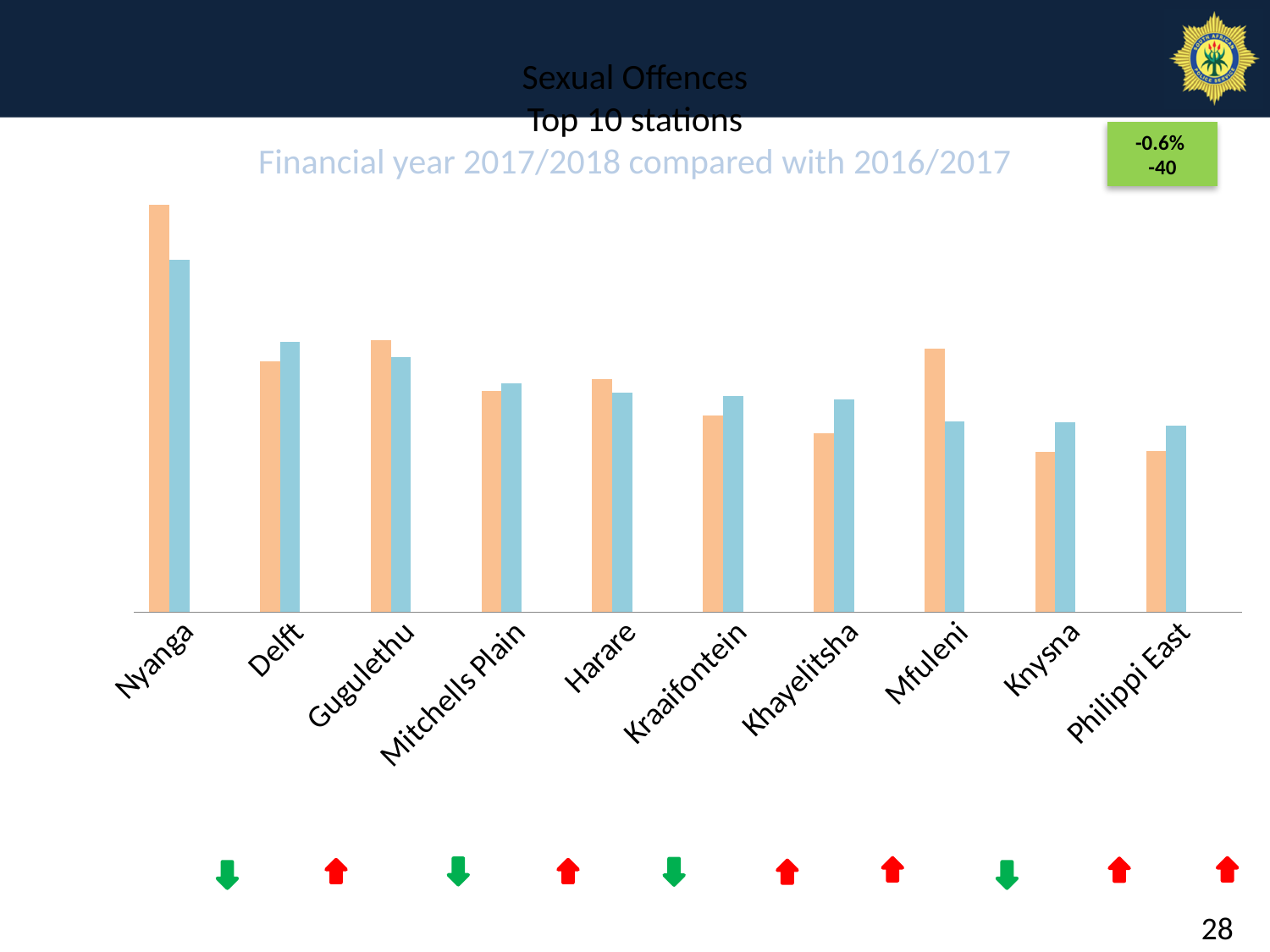
How many stations are shown on the x axis of the chart? 10 What percentage change is shown in the green box at the top right of the slide? -0.6% Which station has the taller orange bar, Mfuleni or Khayelitsha? Mfuleni What kind of chart is shown on the slide? bar chart For Delft, is the orange bar or the blue bar taller? blue For Nyanga, is the orange bar or the blue bar taller? orange Do the bar heights generally rise or fall from left to right across the stations? fall How many bars are plotted for each station? 2 Which station is listed first on the x axis? Nyanga Which station has the highest bars in the chart? Nyanga